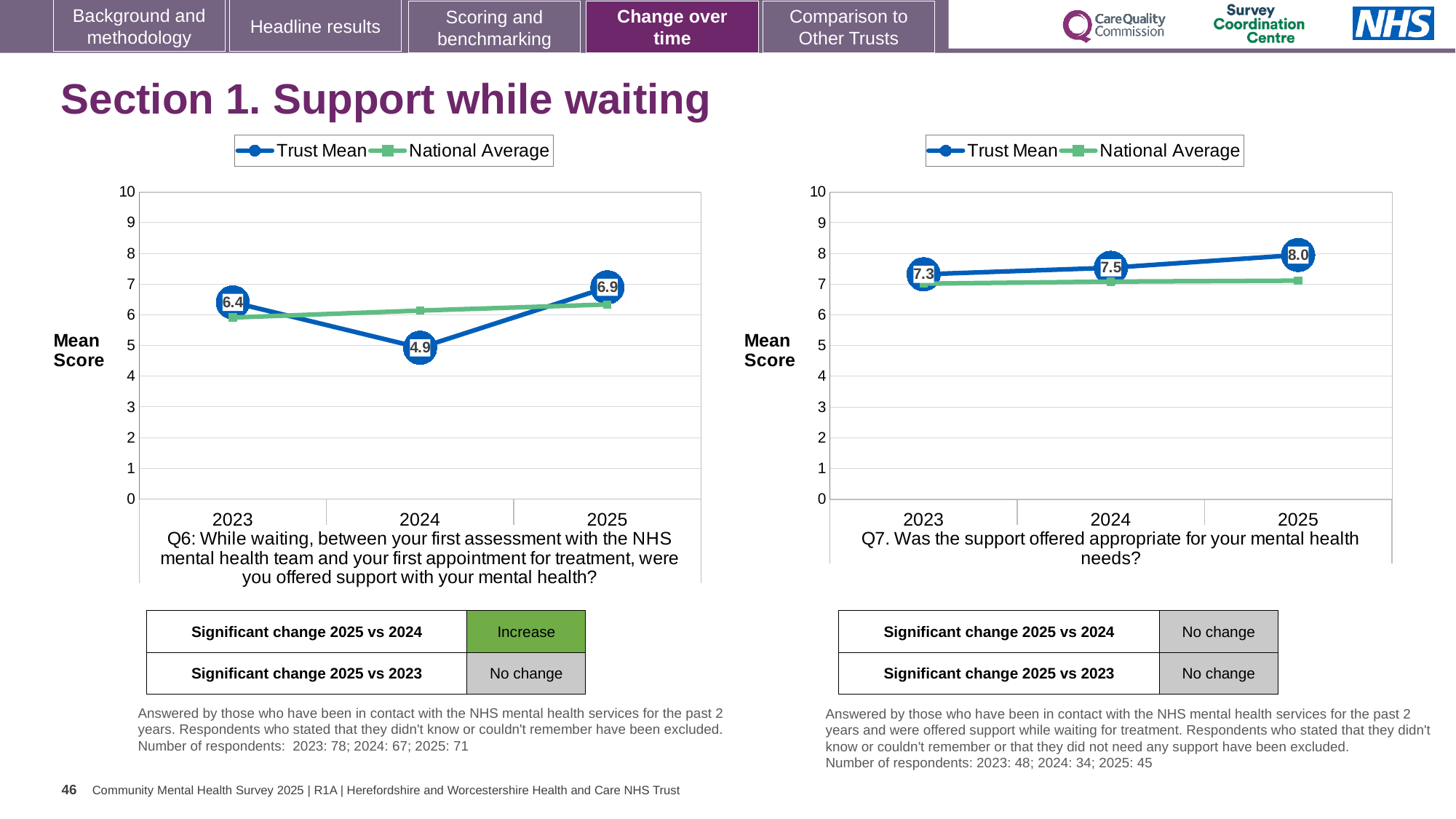
In the left chart (Q6), is the Trust Mean for 2024 greater or less than the National Average for 2024? less In the left chart (Q6), which year has the lowest Trust Mean? 2024 In the left chart (Q6), what is the Trust Mean for 2025? 6.9 In the right chart (Q7), what is the Trust Mean for 2025? 8.0 In the right chart (Q7), what is the difference between the Trust Mean in 2025 and in 2023? 0.7 In the left chart (Q6), what is the difference between the Trust Mean in 2025 and in 2024? 2.0 What type of chart is the left chart (Q6)? Line chart In the right chart (Q7), is the National Average for 2025 greater or less than 8? less In the right chart (Q7), which year has the highest Trust Mean? 2025 In the right chart (Q7), what is the Trust Mean for 2023? 7.3 In the left chart (Q6), what is the Trust Mean for 2024? 4.9 How many series does the legend of the right chart (Q7) list? 2